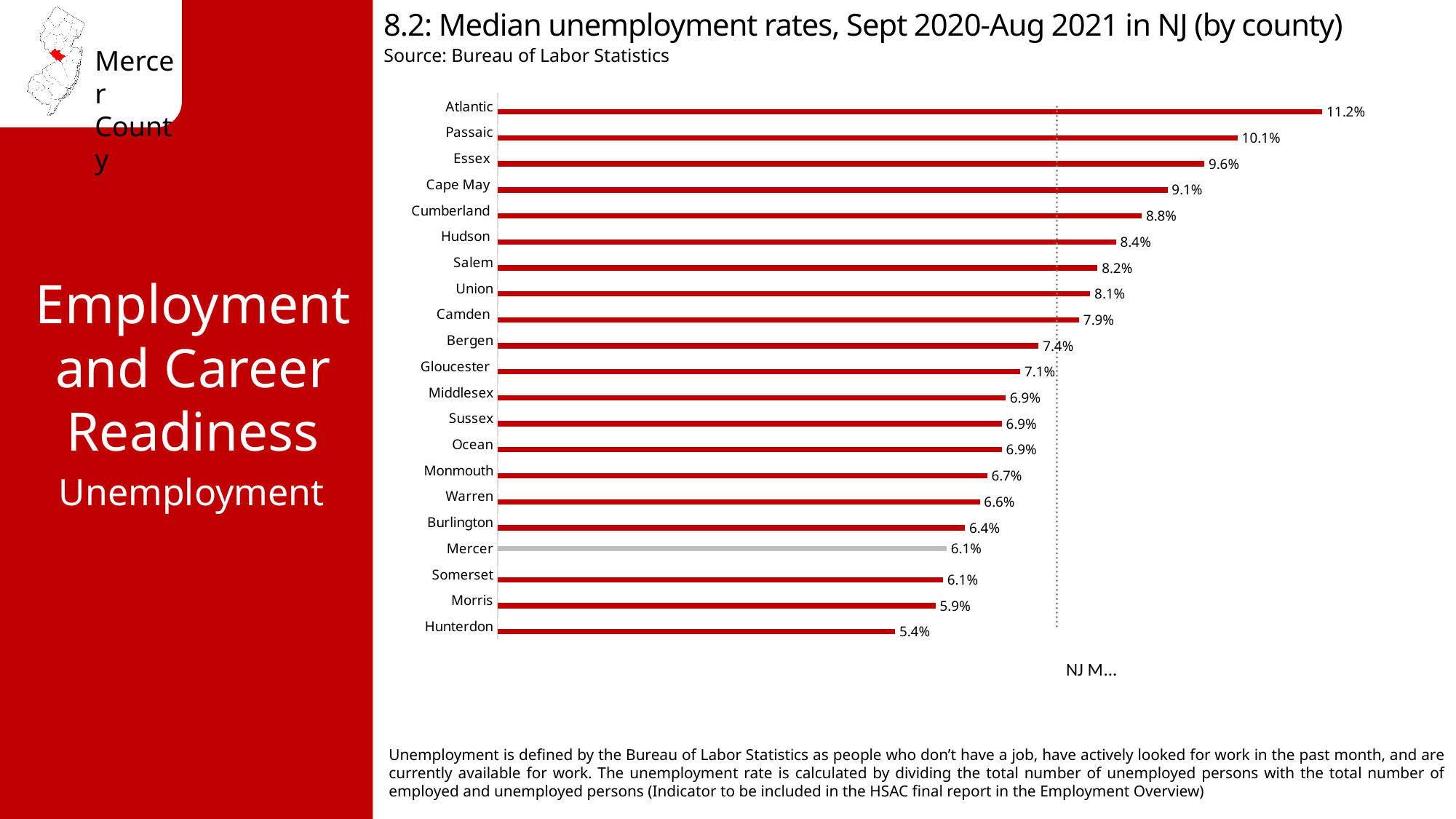
How many counties are shown in the chart? 21 Which county has the highest median unemployment rate? Atlantic What is the median unemployment rate for Hudson County? 8.4% What is the median unemployment rate for Atlantic County? 11.2% What is the median unemployment rate for Mercer County? 6.1% Which county has the lowest median unemployment rate? Hunterdon Which county has a higher median unemployment rate, Essex or Camden? Essex What type of chart is used to show the median unemployment rates? Bar chart What is the difference between the median unemployment rates of Atlantic and Hunterdon counties? 5.8% What is the difference between the median unemployment rates of Passaic and Mercer counties? 4.0% Which county's bar is shown in grey instead of red? Mercer Which county has a higher median unemployment rate, Bergen or Morris? Bergen